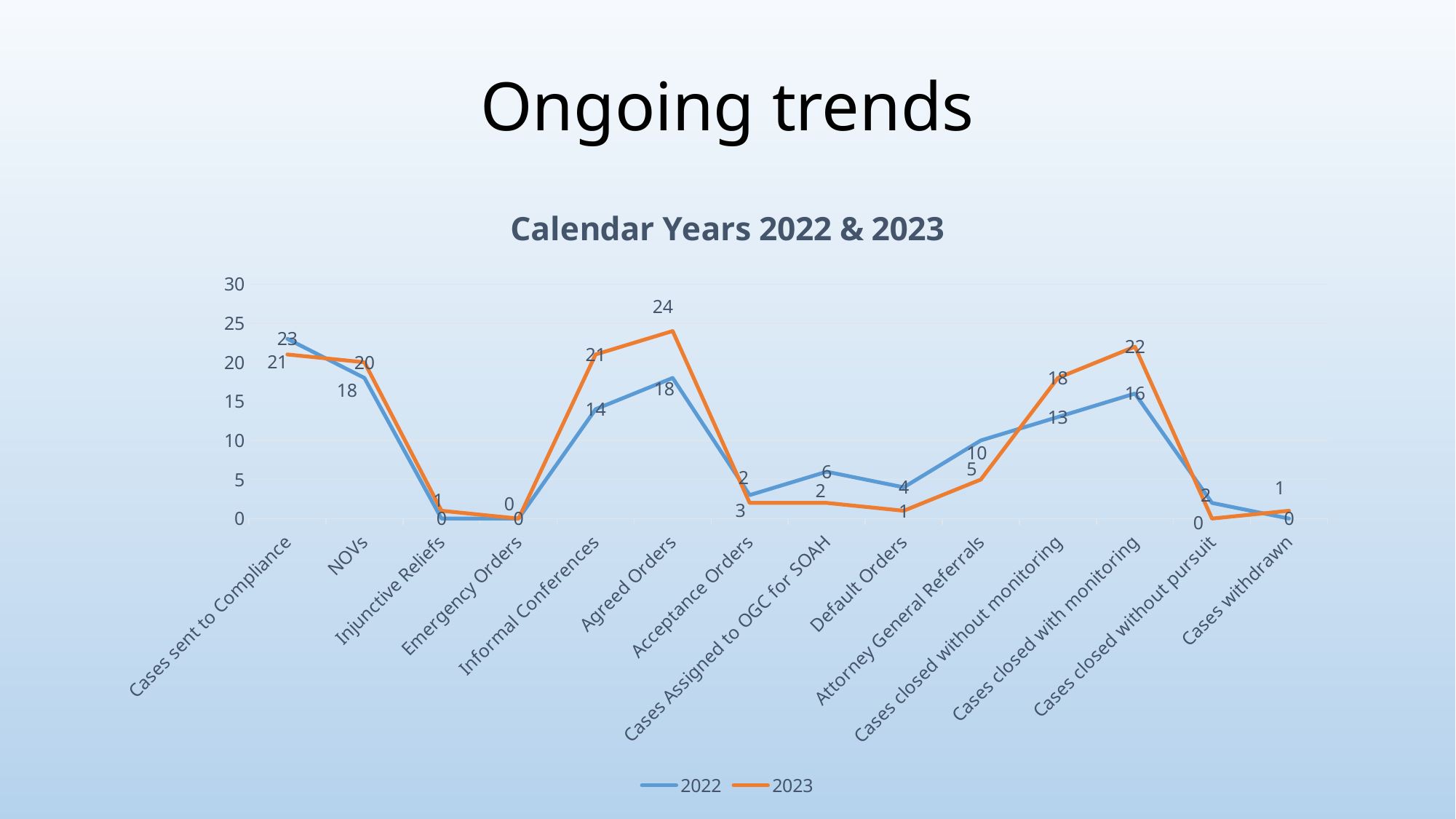
Which category has the highest 2023 value? Agreed Orders How many series does the legend list? 2 What is the 2023 value for Attorney General Referrals? 5 Which is larger for Cases Assigned to OGC for SOAH, the 2022 value or the 2023 value? 2022 What is the 2023 value for Agreed Orders? 24 What is the 2022 value for Cases closed with monitoring? 16 What is the title of the chart? Calendar Years 2022 & 2023 What type of chart is shown on the slide? line chart What is the difference between the 2023 and 2022 values for Cases closed with monitoring? 6 Which category has the highest 2022 value? Cases sent to Compliance What is the difference between the 2023 and 2022 values for Informal Conferences? 7 How many categories are shown on the x axis? 14